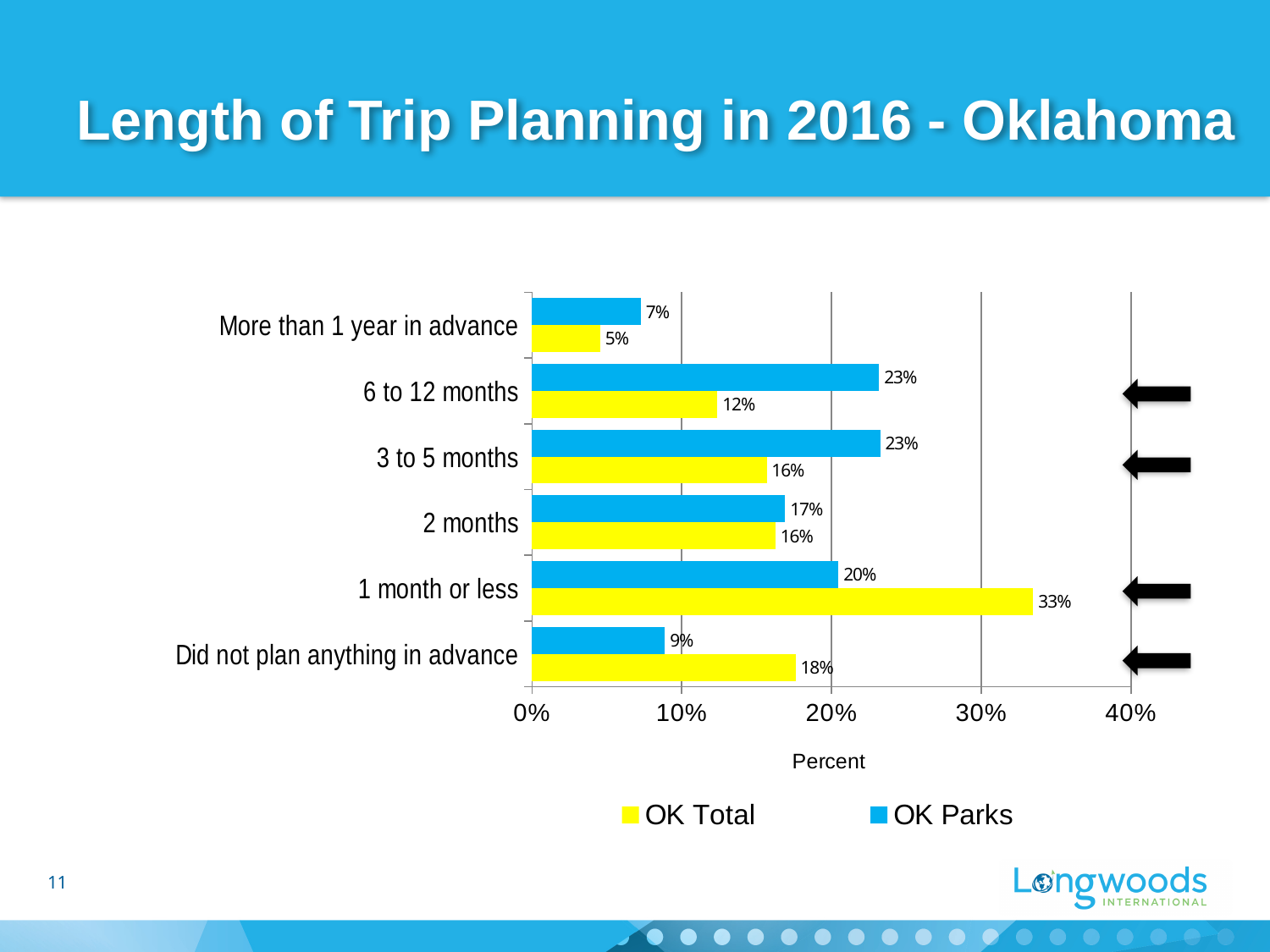
Which category has the lowest OK Parks value? More than 1 year in advance What is the OK Parks value for 6 to 12 months? 23% How many categories are shown on the chart? 6 What is the OK Total value for 1 month or less? 33% What kind of chart is shown on the slide? Bar chart Which category has the highest OK Total value? 1 month or less What is the OK Total value for Did not plan anything in advance? 18% What is the OK Parks value for More than 1 year in advance? 7% How many series does the legend list? 2 Which is larger for 3 to 5 months, OK Total or OK Parks? OK Parks What is the title of the chart? Length of Trip Planning in 2016 - Oklahoma What is the difference between the OK Total and OK Parks values for 1 month or less? 13%